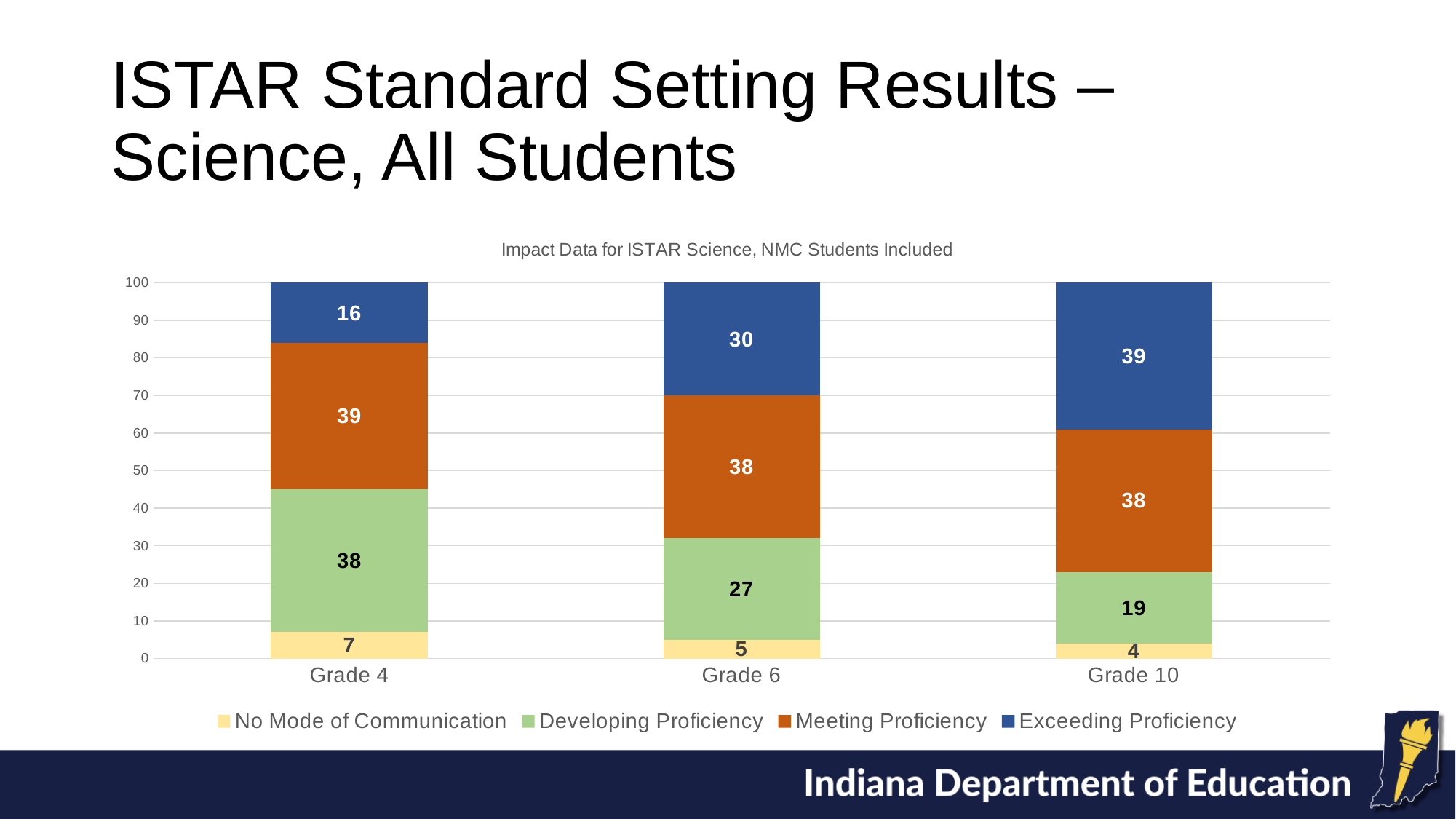
What is the difference between the Developing Proficiency values for Grade 4 and Grade 10? 19 What is the Developing Proficiency value for Grade 6? 27 What is the total of the stacked bar for Grade 6? 100 What is the Exceeding Proficiency value for Grade 10? 39 Which is larger, the Exceeding Proficiency value for Grade 4 or for Grade 6? Grade 6 Does the Exceeding Proficiency value rise or fall from Grade 4 to Grade 10? Rise How many series does the legend list? 4 How many grade categories are shown on the x axis? 3 Which grade has the highest Exceeding Proficiency value? Grade 10 What is the No Mode of Communication value for Grade 4? 7 Which grade has the lowest No Mode of Communication value? Grade 10 What kind of chart is shown on the slide? Stacked bar chart